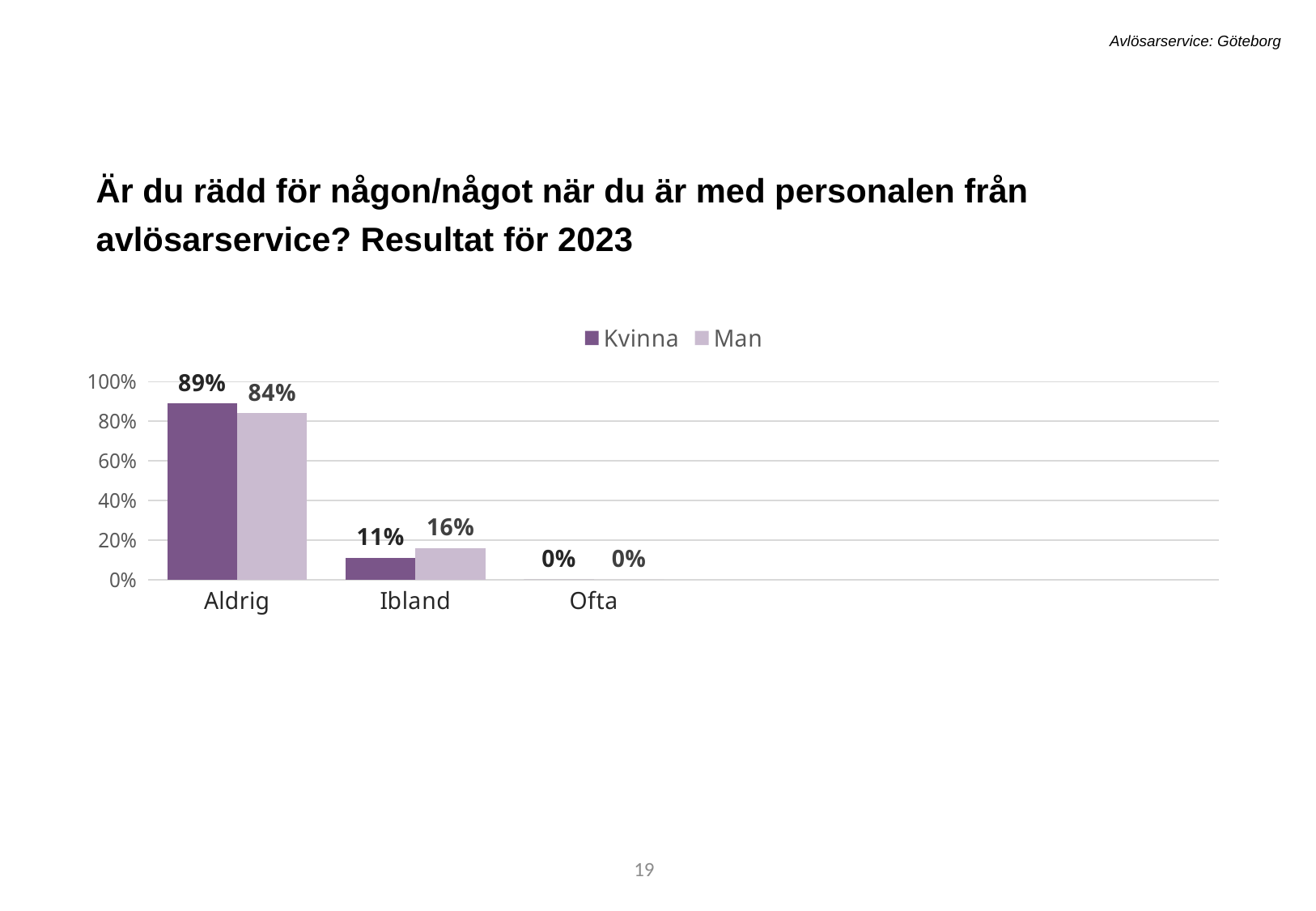
What is the value for Kvinna in the Ibland category? 11% What kind of chart is shown on the slide? Bar chart How many series does the legend list? 2 What is the value for Man in the Aldrig category? 84% What is the difference between the Kvinna and Man values in the Aldrig category? 5% How many categories are shown on the x axis? 3 Which category has the lowest value for Man? Ofta What is the value for Man in the Ibland category? 16% What is the value for Man in the Ofta category? 0% In the Ibland category, which series has the larger value, Kvinna or Man? Man Which category has the highest value for Kvinna? Aldrig What is the value for Kvinna in the Aldrig category? 89%